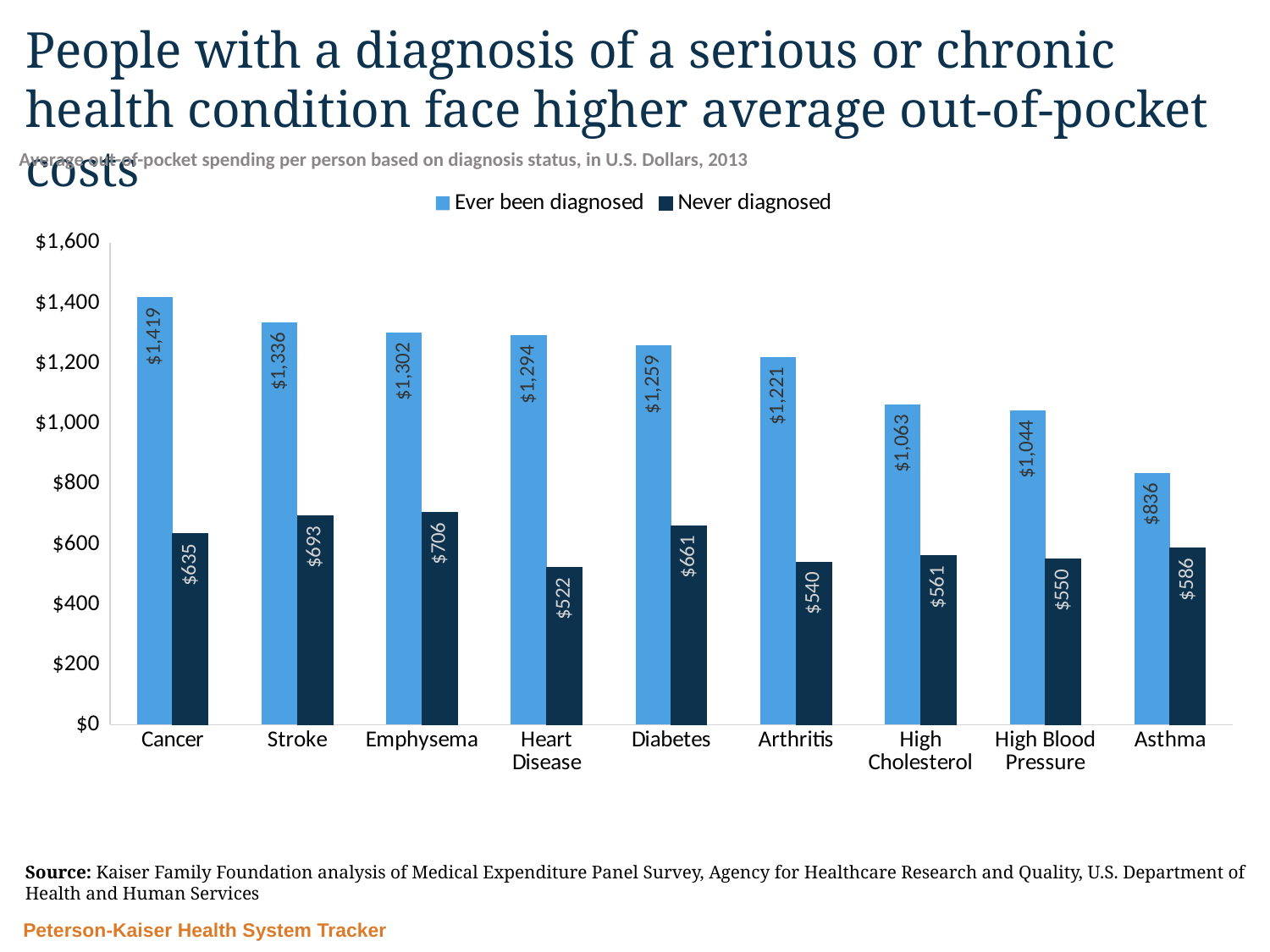
How many health conditions are shown on the x axis? 9 Which condition has the lowest average out-of-pocket spending among people who have ever been diagnosed? Asthma Is the Ever been diagnosed value for High Cholesterol greater or less than $1,000? greater Which condition has the highest average out-of-pocket spending among people who have ever been diagnosed? Cancer Which condition has the highest value in the Never diagnosed series? Emphysema Which is larger: the Never diagnosed value for Stroke or for Arthritis? Stroke What is the average out-of-pocket spending for people who have ever been diagnosed with Cancer? $1,419 What kind of chart is shown on the slide? Bar chart What year does the chart subtitle say the data is from? 2013 What is the difference between the Ever been diagnosed and Never diagnosed values for Diabetes? $598 What is the average out-of-pocket spending for people never diagnosed with Heart Disease? $522 How many series does the legend list? 2